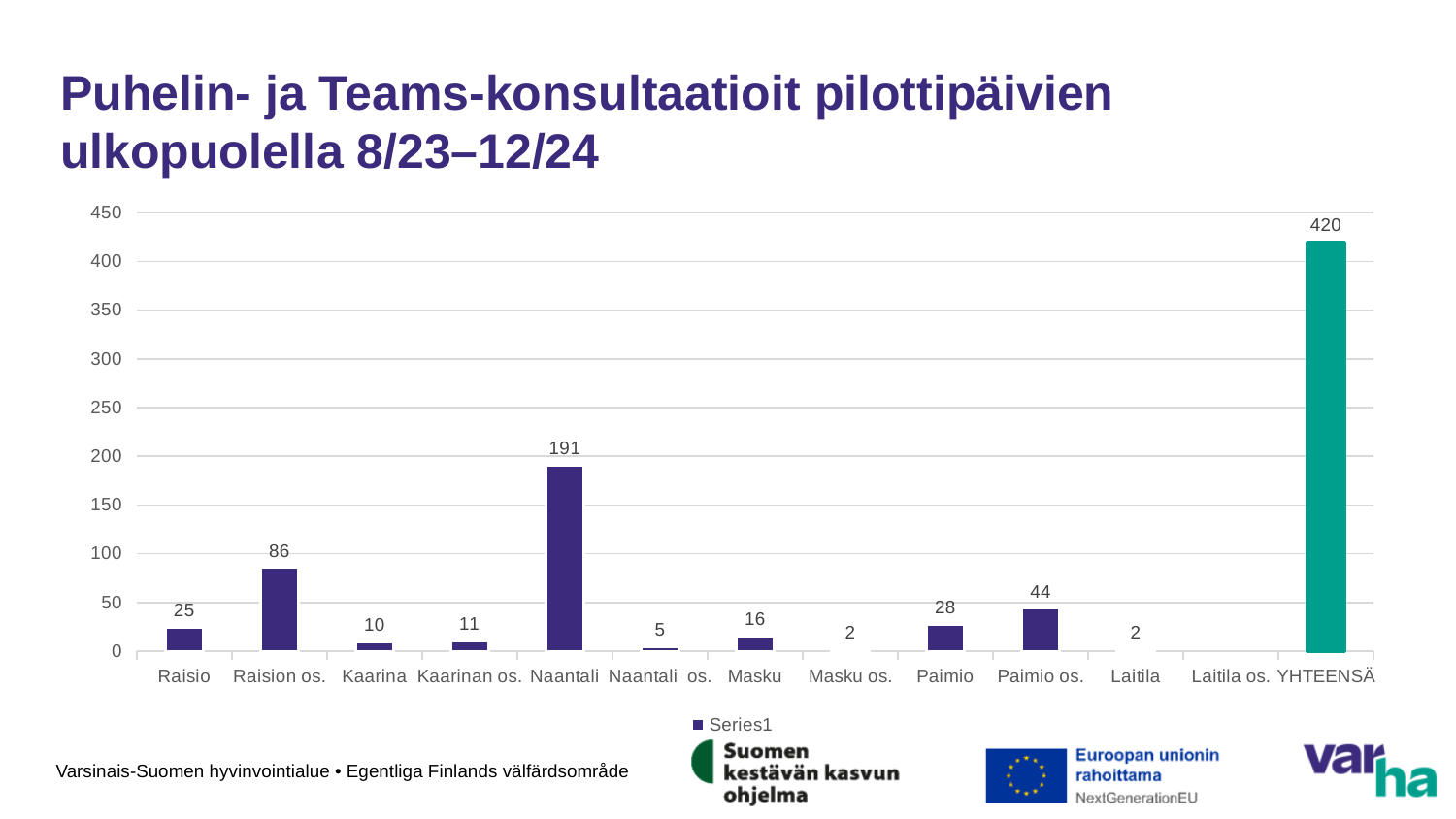
How many categories are shown on the x axis? 13 What is the difference between the values for Naantali and Raision os.? 105 Excluding the YHTEENSÄ total, which category has the highest value? Naantali What is the value for Naantali? 191 How many series does the legend list? 1 What is the value for Raision os.? 86 What kind of chart is shown on the slide? bar chart Which is larger, the value for Paimio or the value for Paimio os.? Paimio os. What is the value for Paimio os.? 44 What is the value shown for YHTEENSÄ? 420 Which category has the highest bar in the chart? YHTEENSÄ Is the value for YHTEENSÄ greater or less than 400? greater